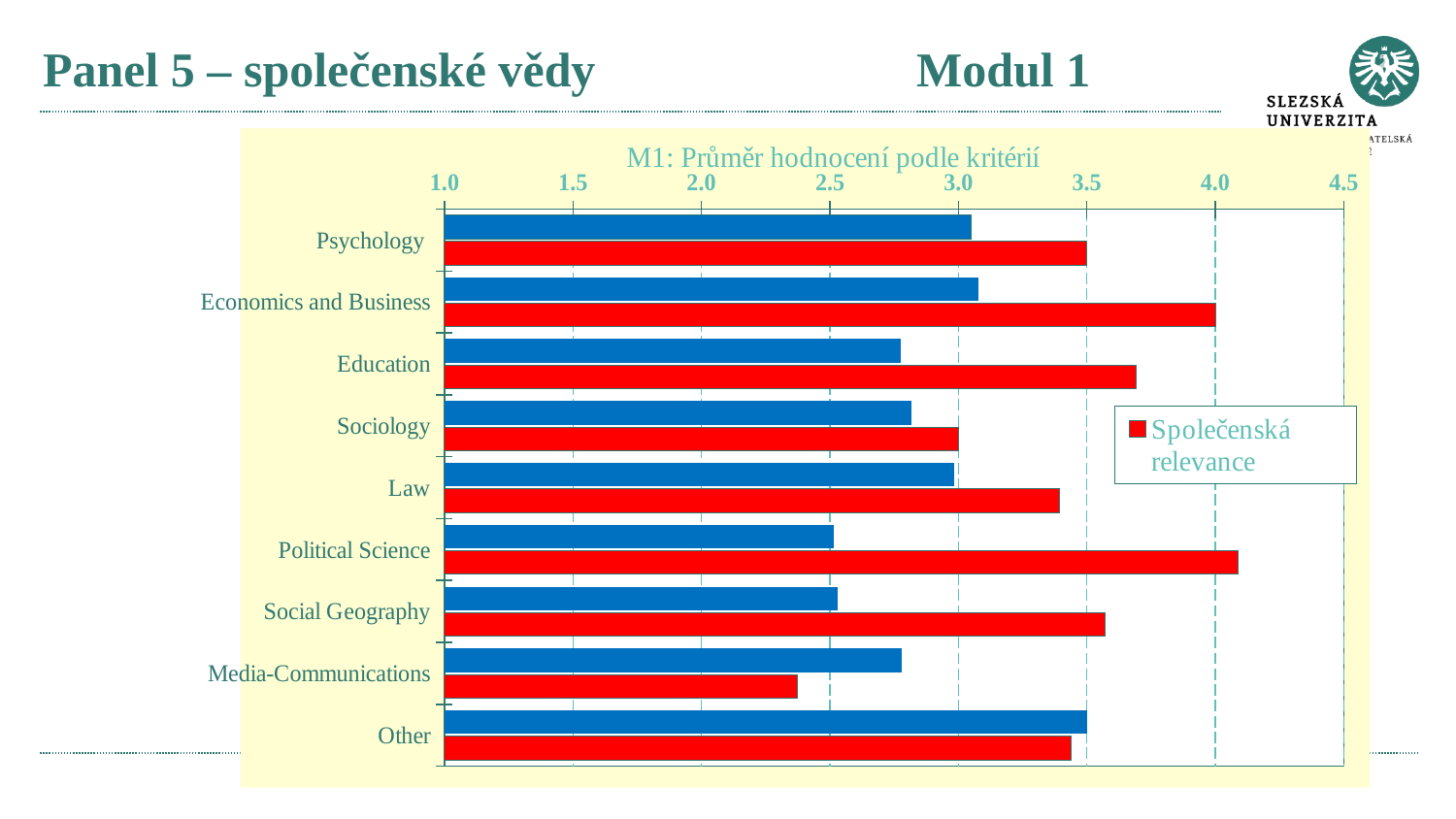
Is the red 'Společenská relevance' value for Political Science greater or less than 4.0? greater What is the title of the chart? M1: Průměr hodnocení podle kritérií Is the red 'Společenská relevance' value for Education greater or less than 3.5? greater Which category has the highest value for the blue series? Other Which category has the highest value for the red 'Společenská relevance' series? Political Science Is the red 'Společenská relevance' value for Media-Communications greater or less than 2.5? less How many categories are listed on the vertical axis of the chart? 9 For Media-Communications, which is larger: the blue bar or the red 'Společenská relevance' bar? the blue bar Which category has the lowest value for the red 'Společenská relevance' series? Media-Communications What kind of chart is shown on the slide? bar chart Which colour are the bars for the legend entry 'Společenská relevance'? red